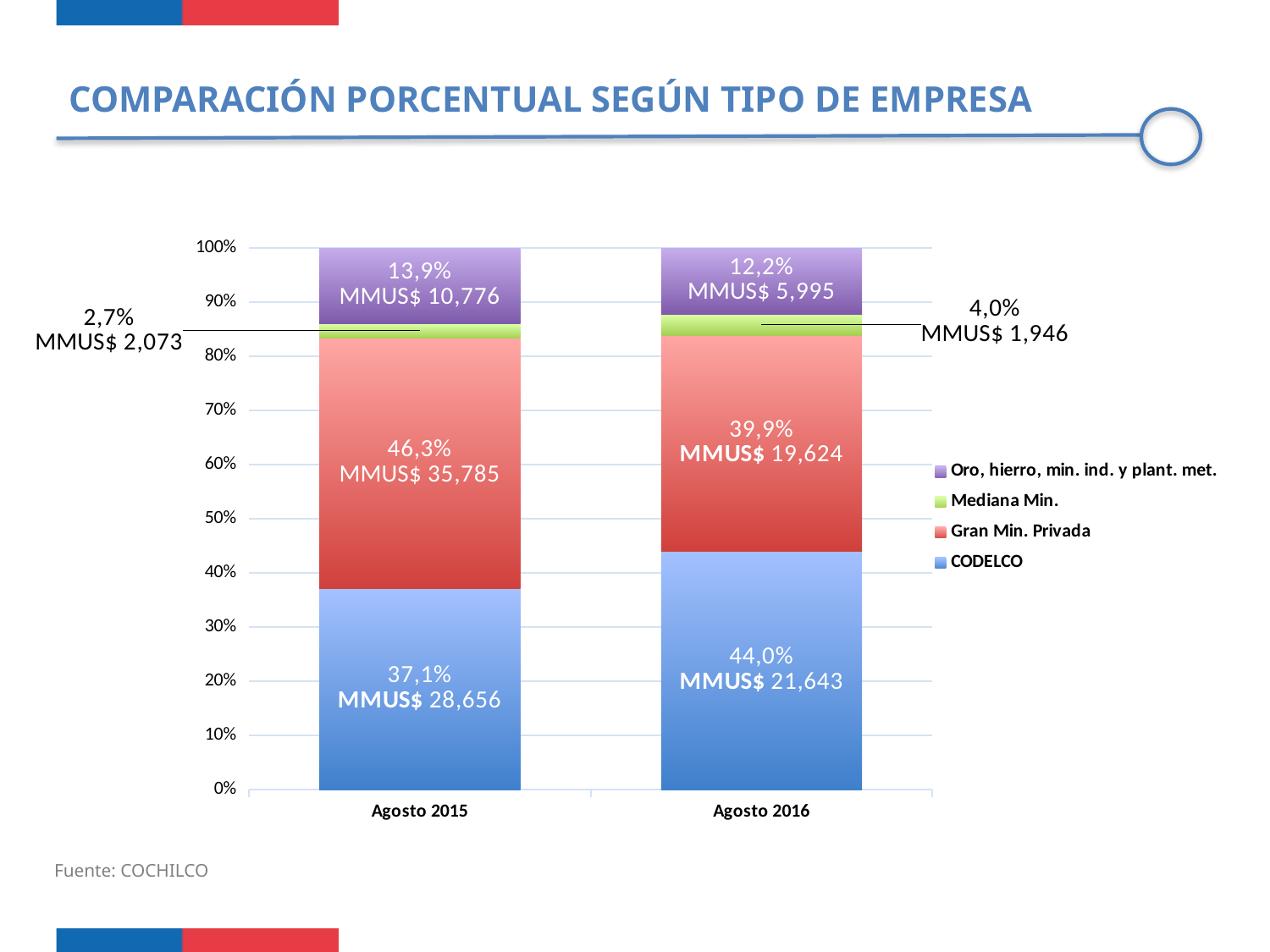
What is the MMUS$ value for Mediana Min. in Agosto 2015? MMUS$ 2,073 How many categories are shown on the x axis? 2 What percentage share does Oro, hierro, min. ind. y plant. met. have in Agosto 2016? 12,2% Does the share of Gran Min. Privada rise or fall from Agosto 2015 to Agosto 2016? Fall What type of chart is shown on the slide? Stacked bar chart Which is larger in Agosto 2016: the share of CODELCO or the share of Gran Min. Privada? CODELCO Which series has the smallest share in Agosto 2016? Mediana Min. How many series does the legend list? 4 By how many percentage points did CODELCO's share change from Agosto 2015 (37,1%) to Agosto 2016 (44,0%)? 6,9 percentage points What is the MMUS$ value for Gran Min. Privada in Agosto 2016? MMUS$ 19,624 What percentage share does CODELCO have in Agosto 2015? 37,1% Which series has the largest share in Agosto 2015? Gran Min. Privada